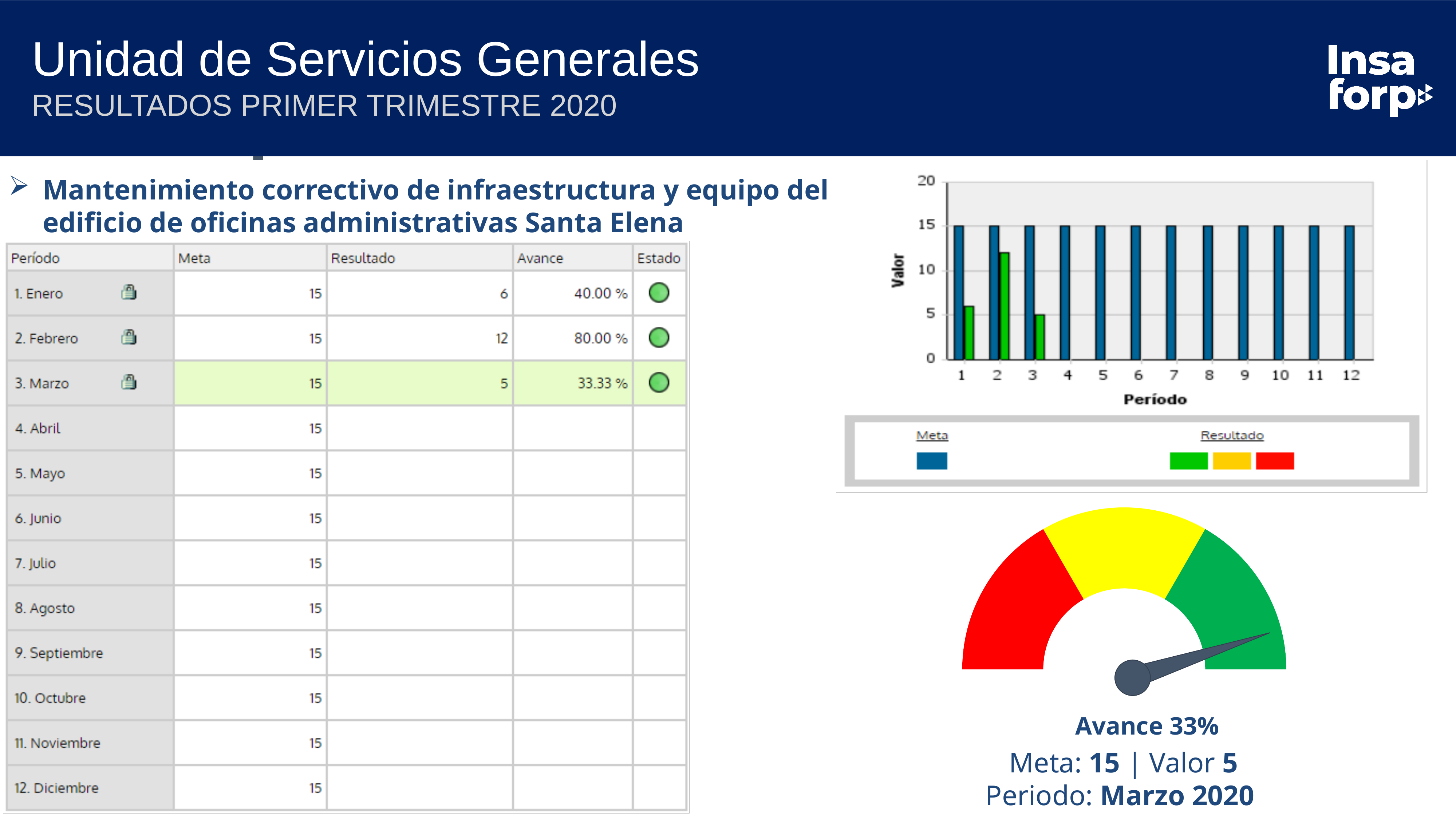
In the bar chart, is the Resultado value for Período 1 greater or less than 10? less In the bar chart, is the Resultado bar for Período 2 larger or smaller than the Resultado bar for Período 1? larger In the bar chart, what is the Meta value for Período 1? 15 What Avance percentage is shown below the gauge chart? 33% In the bar chart, which Período has the lowest Resultado bar among those with a Resultado shown? 3 In the bar chart, is the Resultado value for Período 2 greater or less than 10? greater How many Período categories are shown on the x axis of the bar chart? 12 What kind of chart is the chart with Valor on the y axis and Período on the x axis? bar chart What is the label of the y axis of the bar chart? Valor In the bar chart, is the Resultado value for Período 3 greater or less than 10? less In the bar chart, which Período has the highest Resultado bar? 2 In the bar chart, what is the Meta value for Período 12? 15